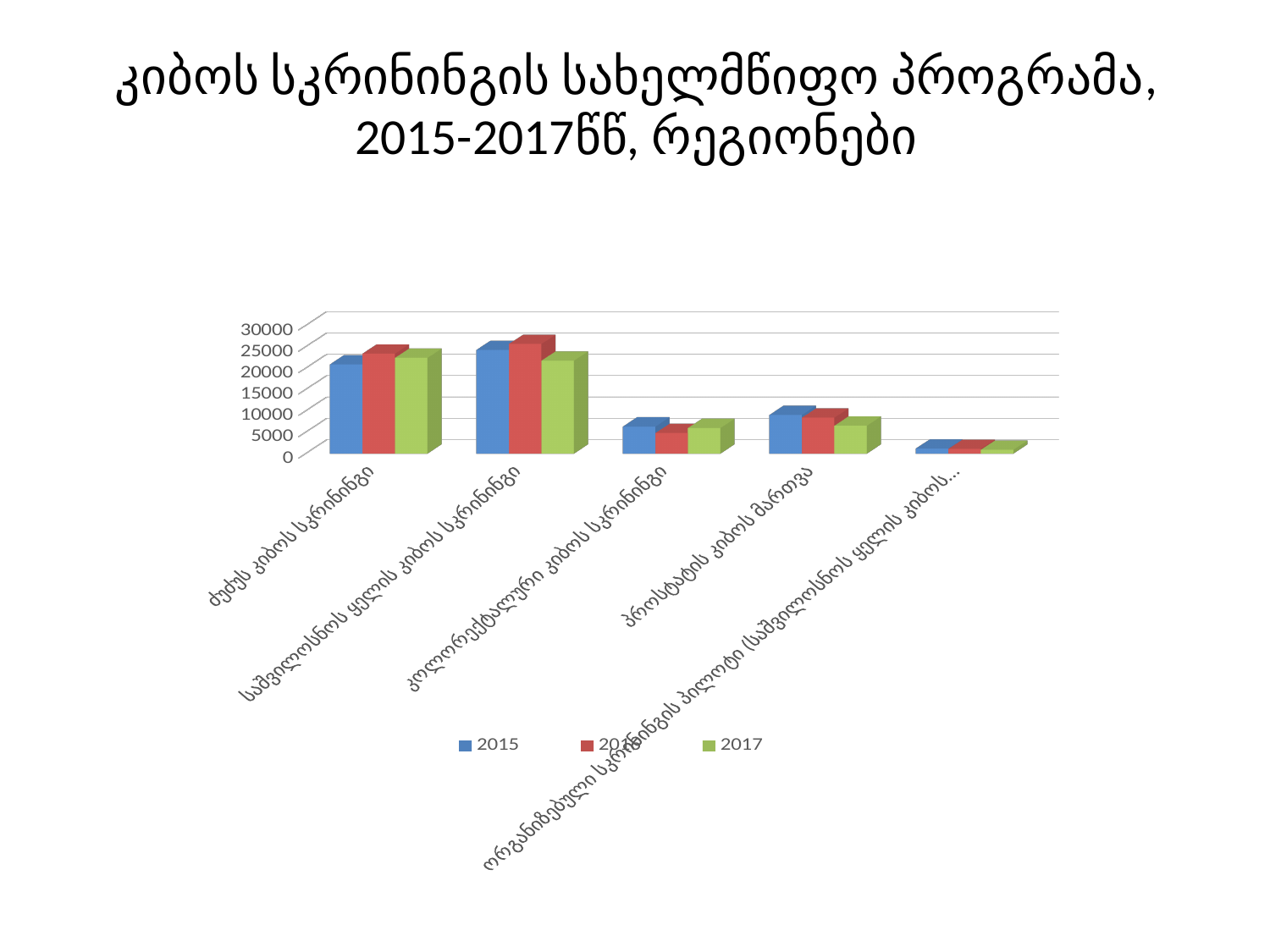
What kind of chart is shown on the slide? bar chart Is the 2016 value for ძუძუს კიბოს სკრინინგი greater or less than 20000? greater How many categories are shown on the x axis? 5 Which years are listed in the legend? 2015, 2016, 2017 Is the 2015 value for კოლორექტალური კიბოს სკრინინგი greater or less than 10000? less Is the 2017 value for ორგანიზებული სკრინინგის პილოტი greater or less than 5000? less How many series does the legend list? 3 Which category has the highest bar in the chart? საშვილოსნოს ყელის კიბოს სკრინინგი Which category has the lowest values across all three years? ორგანიზებული სკრინინგის პილოტი (საშვილოსნოს ყელის კიბოს... Which is larger: the 2016 value for ძუძუს კიბოს სკრინინგი or the 2016 value for კოლორექტალური კიბოს სკრინინგი? ძუძუს კიბოს სკრინინგი What is the title of the chart slide? კიბოს სკრინინგის სახელმწიფო პროგრამა, 2015-2017წწ, რეგიონები